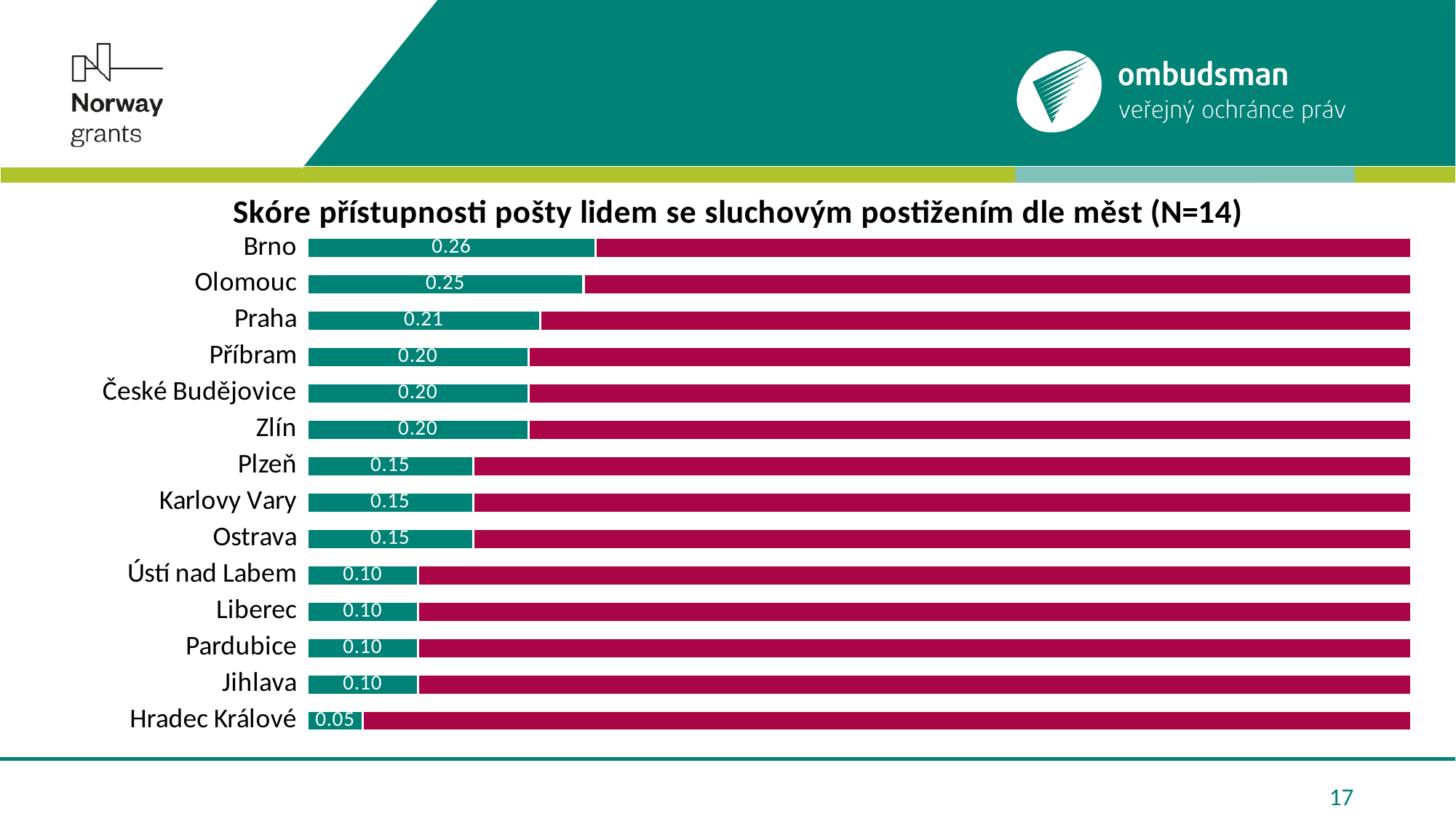
What is the accessibility score for Praha? 0.21 What is the title of the chart? Skóre přístupnosti pošty lidem se sluchovým postižením dle měst (N=14) What is the accessibility score for Brno? 0.26 Which city has a higher score, Praha or Plzeň? Praha What is the accessibility score for Hradec Králové? 0.05 Which city has the lowest accessibility score? Hradec Králové What type of chart is shown on the slide? Bar chart Which city has the highest accessibility score? Brno How many cities are shown in the chart? 14 What is the difference between the scores of Brno and Olomouc? 0.01 What is the difference between the scores of Brno and Hradec Králové? 0.21 What is the accessibility score for Karlovy Vary? 0.15